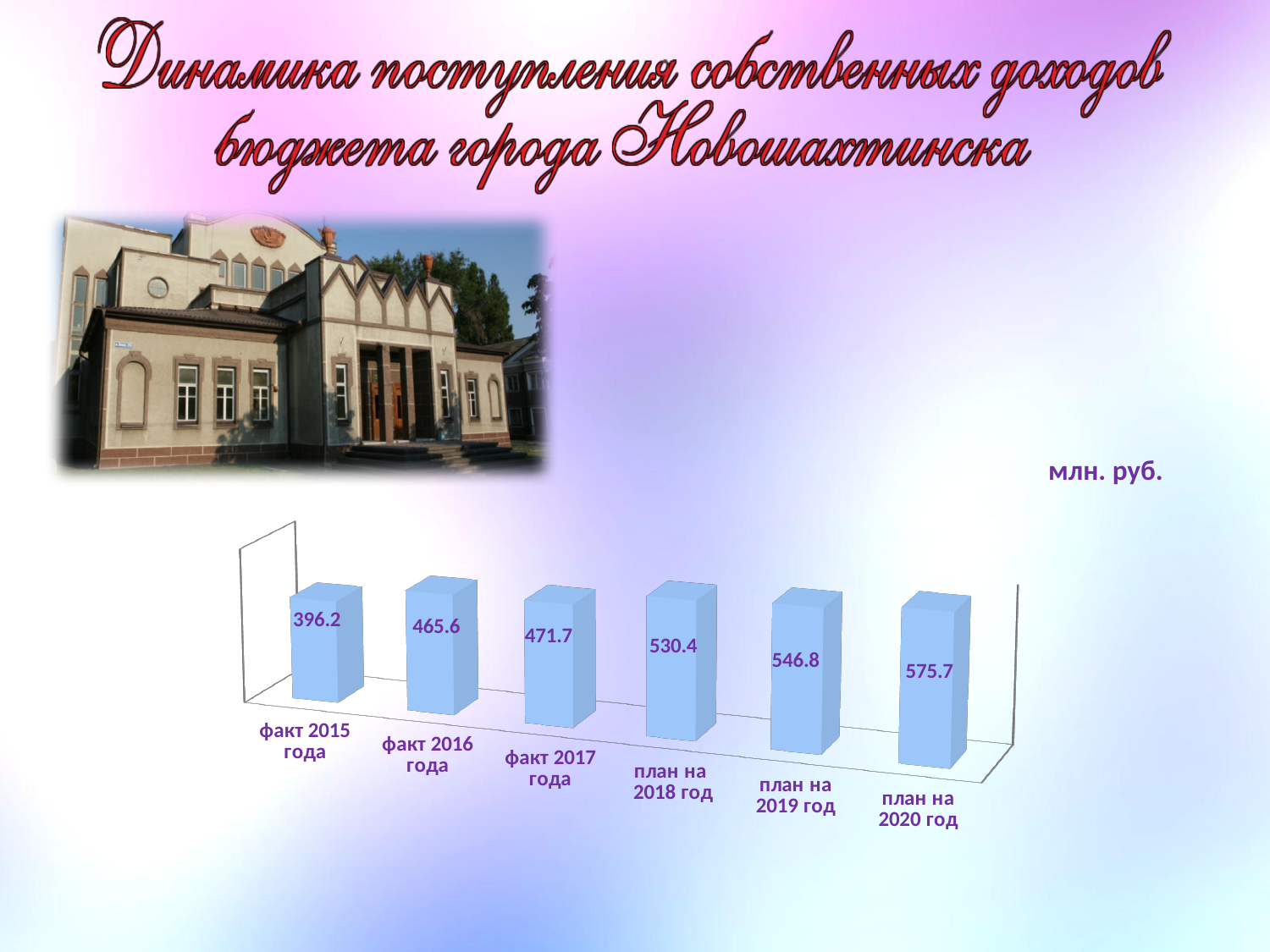
Which is larger, the value for план на 2019 год or the value for план на 2018 год? план на 2019 год What is the difference between the values for факт 2016 года and факт 2015 года? 69.4 What is the difference between the values for план на 2020 год and факт 2015 года? 179.5 What kind of chart is shown on the slide? bar chart What is the value for факт 2015 года? 396.2 Which category has the highest value? план на 2020 год What is the value for факт 2017 года? 471.7 Which category has the lowest value? факт 2015 года What is the value for план на 2018 год? 530.4 Do the values rise or fall from факт 2015 года to план на 2020 год? rise What is the value for план на 2020 год? 575.7 How many categories are shown in the chart? 6